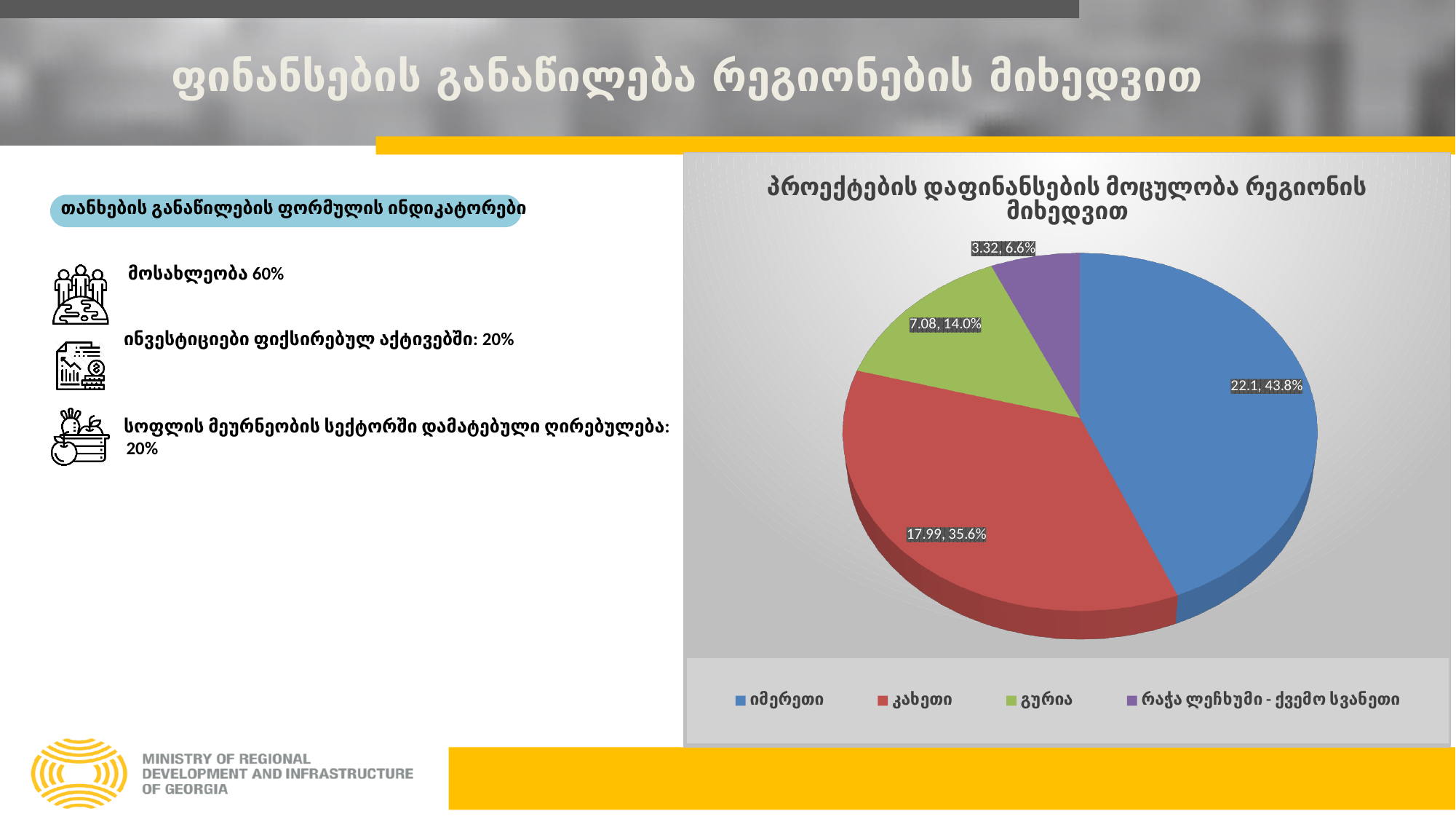
What share of the pie does კახეთი have? 35.6% What is the value for გურია in the pie chart? 7.08 Which region has the smallest slice of the pie? რაჭა ლეჩხუმი - ქვემო სვანეთი How many slices does the pie chart have? 4 What is the value for იმერეთი in the pie chart? 22.1 Which region has the largest slice of the pie? იმერეთი Which colour represents კახეთი in the pie chart? red What share of the pie does რაჭა ლეჩხუმი - ქვემო სვანეთი have? 6.6% Which is larger, the value for გურია or the value for რაჭა ლეჩხუმი - ქვემო სვანეთი? გურია What is the title of the pie chart? პროექტების დაფინანსების მოცულობა რეგიონის მიხედვით What kind of chart is shown on the slide? pie chart What is the difference between the values for იმერეთი and კახეთი? 4.11